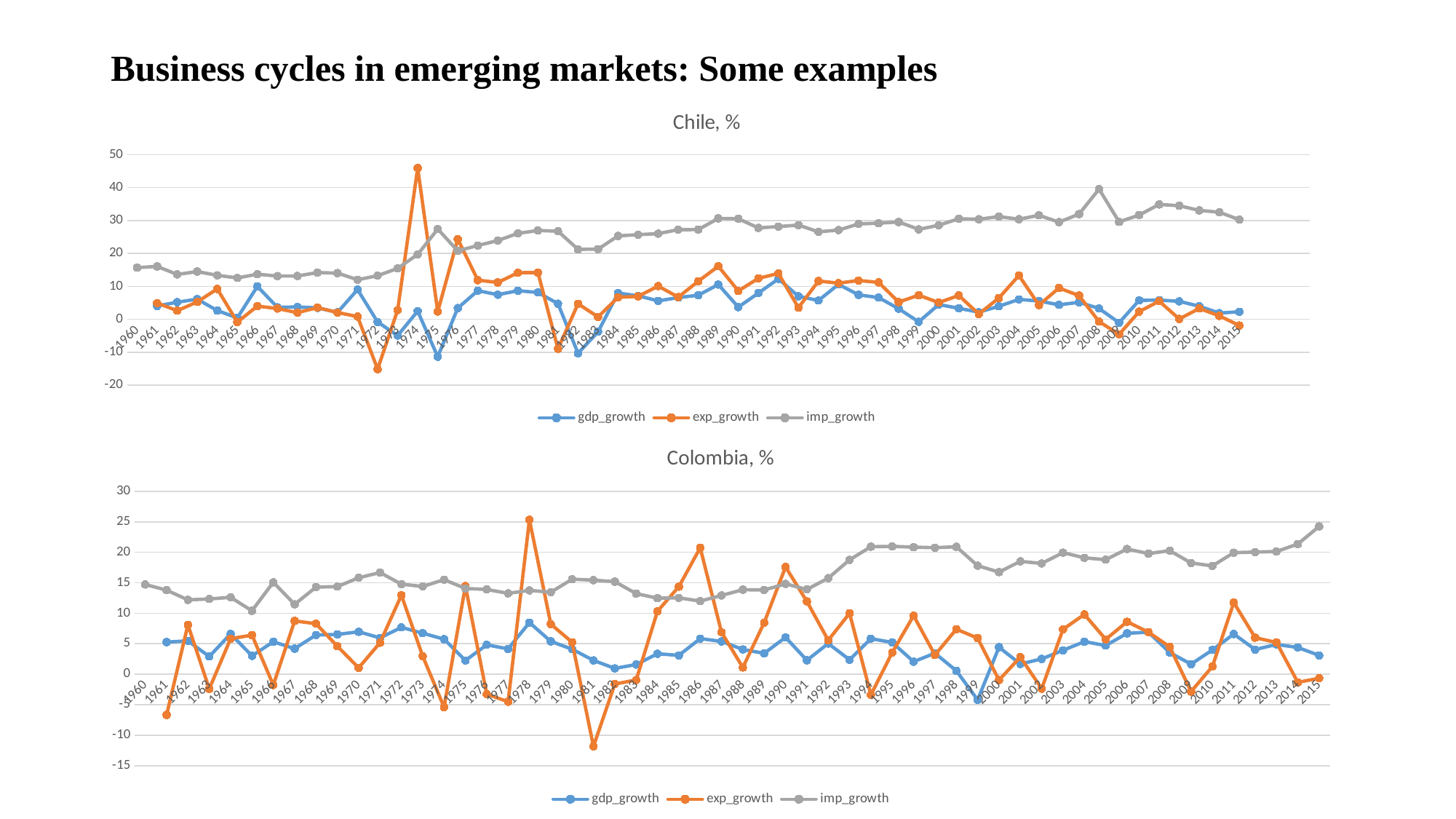
In the "Colombia, %" chart, in which year does exp_growth reach its highest value? 1978 In the "Colombia, %" chart, which series is higher in 1981: gdp_growth or exp_growth? gdp_growth In the "Colombia, %" chart, in which year does exp_growth reach its lowest value? 1981 In the "Colombia, %" chart, is the imp_growth value for 2015 greater or less than 20? greater How many series does the legend of the "Colombia, %" chart list? 3 In the "Chile, %" chart, which series is higher in 2008: imp_growth or gdp_growth? imp_growth What kind of chart is the "Chile, %" chart? line chart In the "Chile, %" chart, is the exp_growth value for 1974 greater or less than 40? greater In the "Chile, %" chart, does imp_growth generally rise or fall from 1960 to 2015? rise In the "Chile, %" chart, in which year does exp_growth reach its highest value? 1974 Which series is shown in orange in the "Colombia, %" chart? exp_growth In the "Chile, %" chart, in which year does exp_growth reach its lowest value? 1972